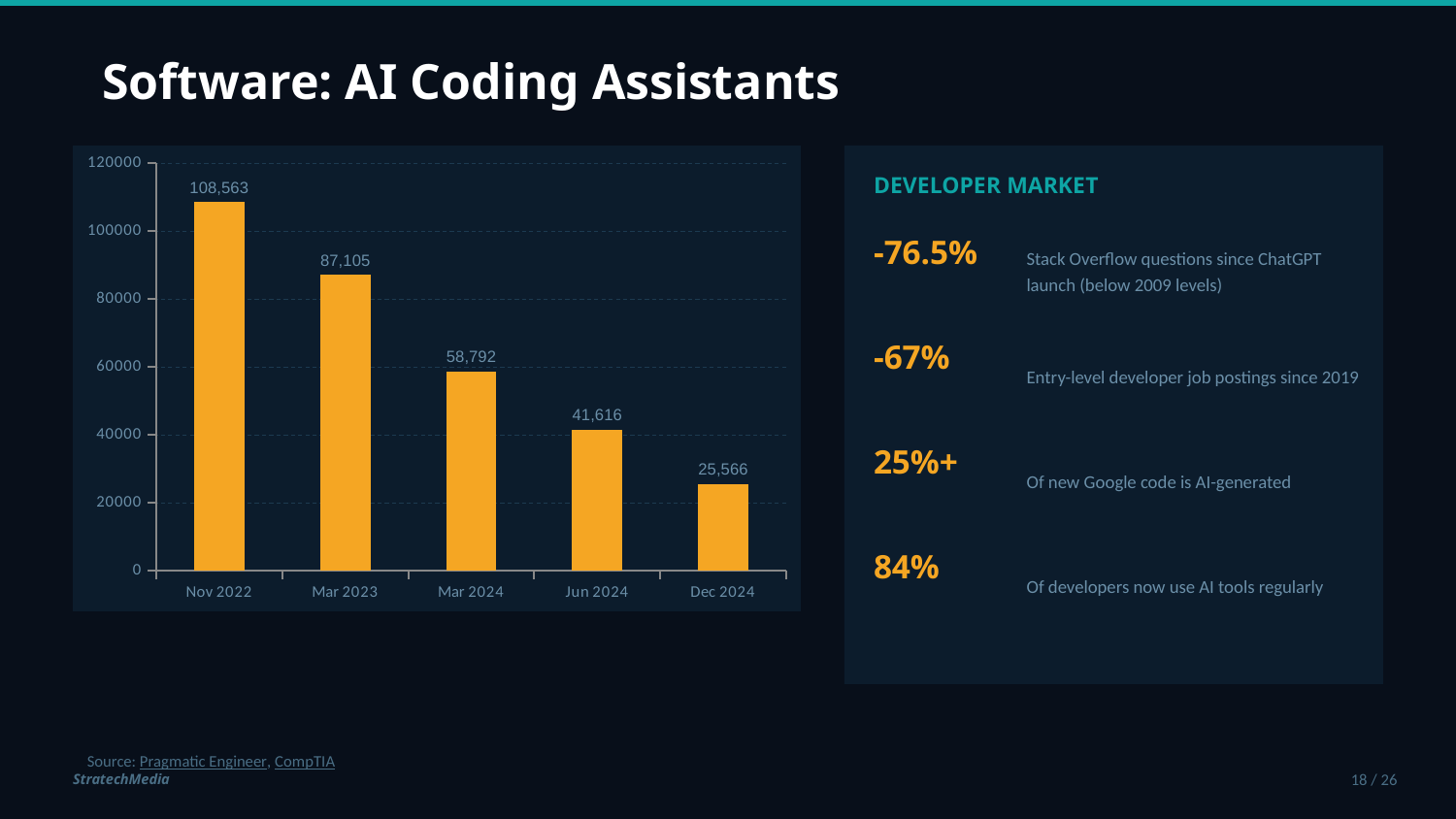
What is the value for Mar 2024? 58,792 What is the difference between the values for Jun 2024 and Dec 2024? 16,050 Which category has the lowest value? Dec 2024 Do the values rise or fall from Nov 2022 to Dec 2024? fall Which is larger, the value for Mar 2023 or the value for Jun 2024? Mar 2023 Is the value for Mar 2024 greater or less than 60000? less How many categories are shown on the x axis? 5 What is the difference between the values for Nov 2022 and Mar 2023? 21,458 What kind of chart is shown on the slide? bar chart What is the value for Nov 2022? 108,563 Which category has the highest value? Nov 2022 What is the value for Dec 2024? 25,566